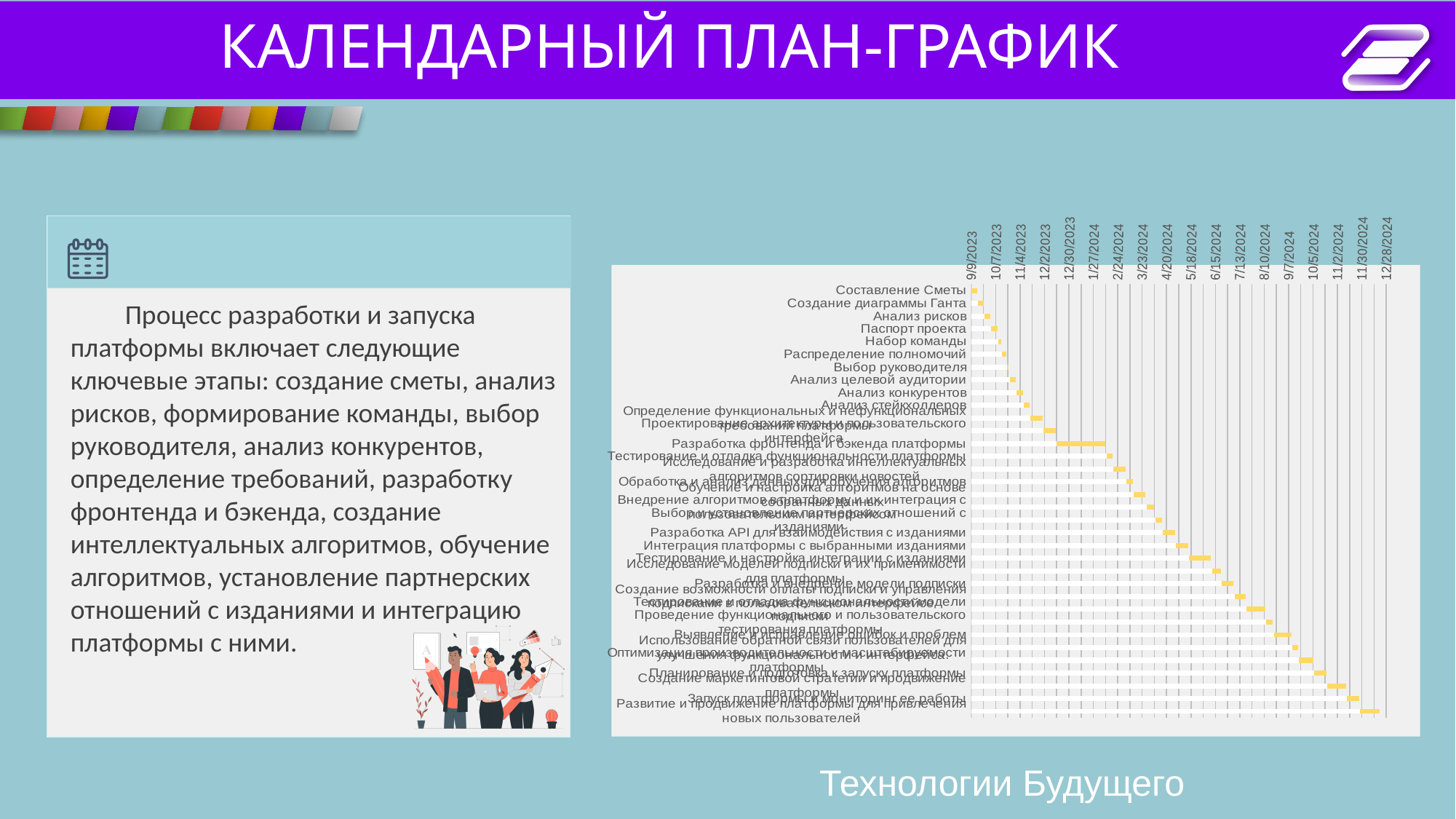
Does the bar for Составление Сметы end before or after 10/7/2023? before What is the first date shown on the horizontal axis of the chart? 9/9/2023 Which task starts earlier: Составление Сметы or Анализ конкурентов? Составление Сметы How many date ticks are shown on the horizontal axis of the chart? 18 Which task is listed first (at the top) of the chart? Составление Сметы Does the bar for Развитие и продвижение платформы для привлечения новых пользователей end before or after 11/30/2024? after What kind of chart is shown on the slide? Bar chart (Gantt chart) Which task is listed last (at the bottom) of the chart? Развитие и продвижение платформы для привлечения новых пользователей Moving down the list of tasks, do the bars shift to later or earlier dates? later Which task has the longest bar in the chart? Разработка фронтенда и бэкенда платформы What is the last date shown on the horizontal axis of the chart? 12/28/2024 What colour are the bars in the chart? Yellow